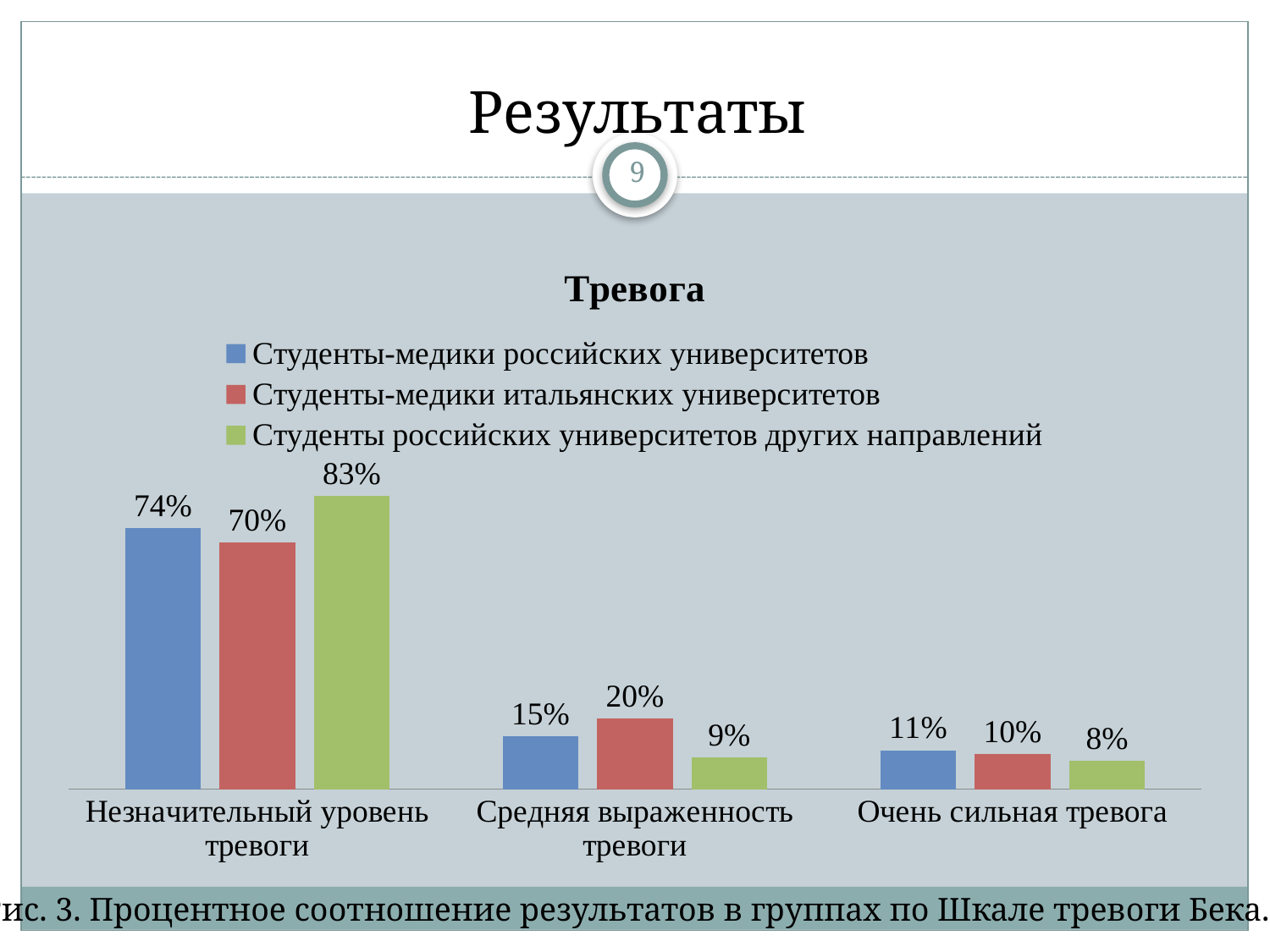
What kind of chart is shown on the slide? Bar chart Which is larger: the value for Студенты-медики российских университетов or Студенты-медики итальянских университетов in the Средняя выраженность тревоги category? Студенты-медики итальянских университетов What is the value for Студенты российских университетов других направлений in the Очень сильная тревога category? 8% What is the value for Студенты российских университетов других направлений in the Незначительный уровень тревоги category? 83% Which series has the lowest value in the Средняя выраженность тревоги category? Студенты российских университетов других направлений What is the title of the chart? Тревога What is the value for Студенты-медики российских университетов in the Незначительный уровень тревоги category? 74% Which series has the highest value in the Незначительный уровень тревоги category? Студенты российских университетов других направлений What is the difference between the values for Студенты российских университетов других направлений and Студенты-медики итальянских университетов in the Незначительный уровень тревоги category? 13% What is the value for Студенты-медики итальянских университетов in the Средняя выраженность тревоги category? 20% How many categories are shown on the x axis? 3 How many series does the legend list? 3